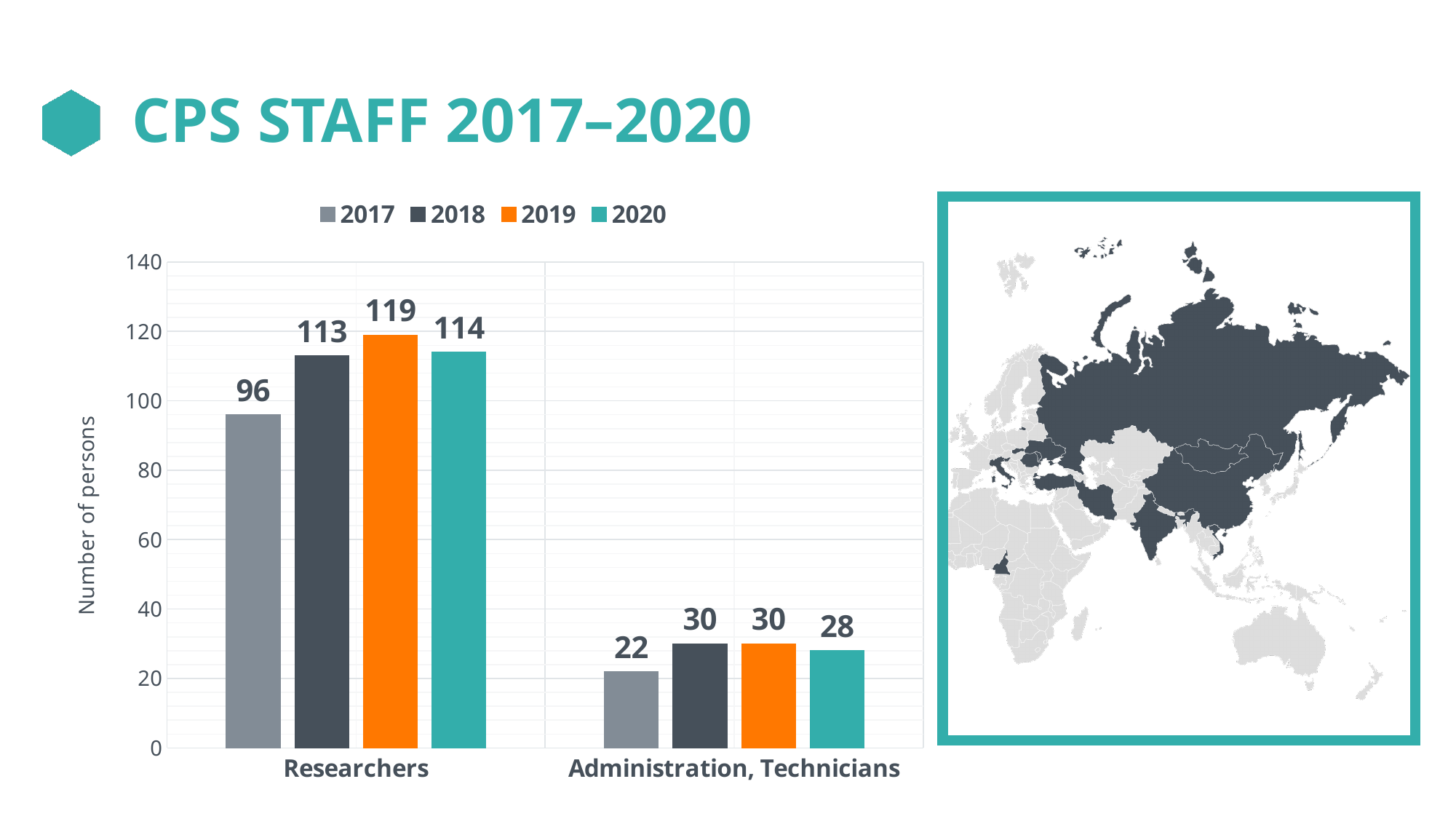
What is the label of the vertical axis? Number of persons What is the difference between the number of Researchers in 2019 and in 2017? 23 What is the value for Administration, Technicians in 2020? 28 What is the value for Researchers in 2019? 119 What kind of chart is shown on the slide? Bar chart How many categories are shown on the x axis? 2 Which year has the lowest value for Administration, Technicians? 2017 Which is larger: Researchers in 2020 or Researchers in 2018? Researchers in 2020 Which year has the highest number of Researchers? 2019 How many Researchers were there in 2017? 96 How many series does the legend list? 4 What is the difference between Researchers and Administration, Technicians in 2018? 83